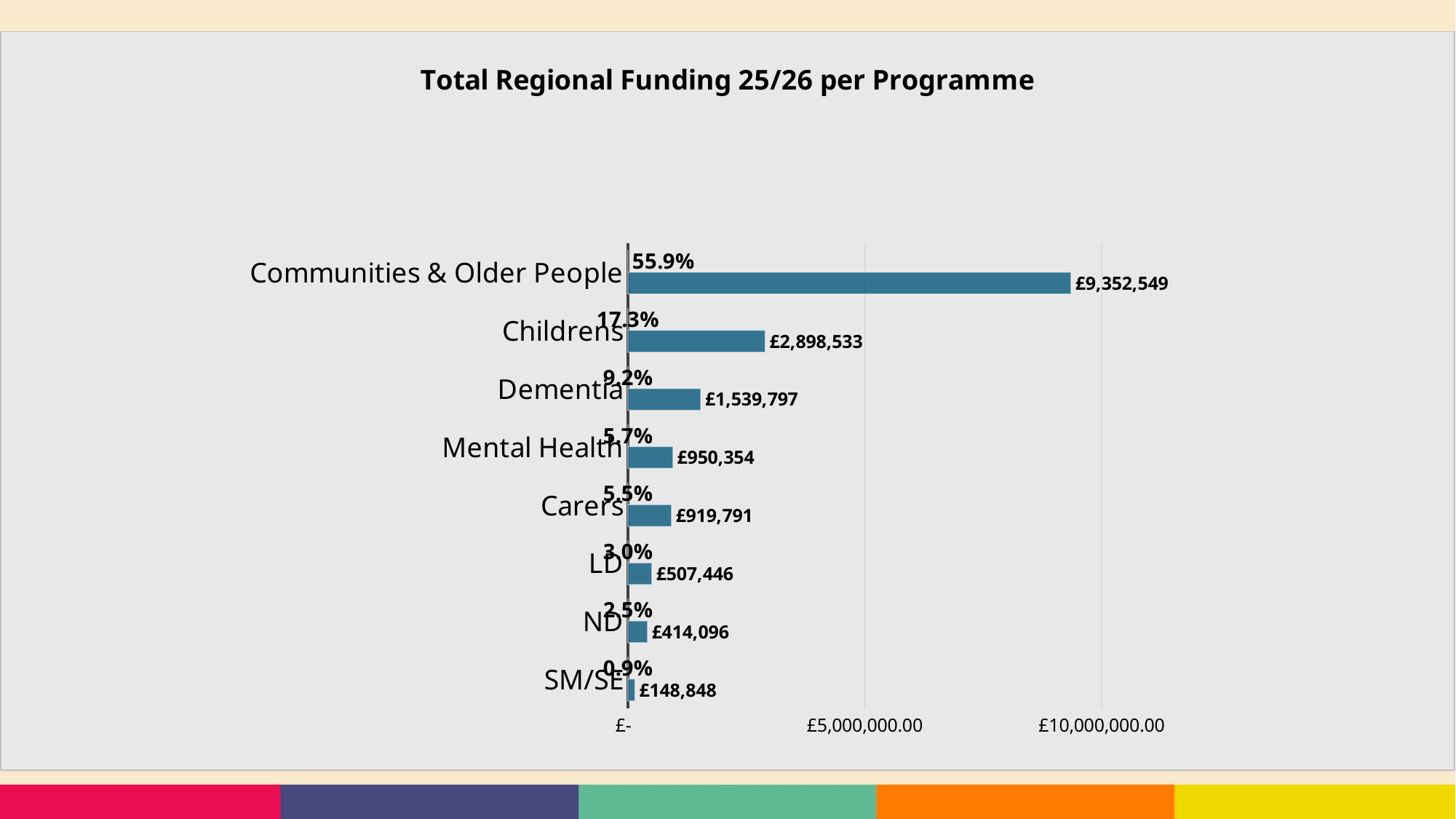
What is the funding value shown for Dementia? £1,539,797 What is the funding value shown for Communities & Older People? £9,352,549 What is the difference in funding between Mental Health and Carers? £30,563 How many programmes are shown in the chart? 8 What is the difference in funding between Communities & Older People and Childrens? £6,454,016 Which programme has the highest funding? Communities & Older People Is the funding for Childrens greater or less than £5,000,000.00? less Which has more funding, LD or ND? LD What type of chart is shown on the slide? Bar chart What is the funding value shown for ND? £414,096 What percentage label is shown for Communities & Older People? 55.9% Which programme has the lowest funding? SM/SE